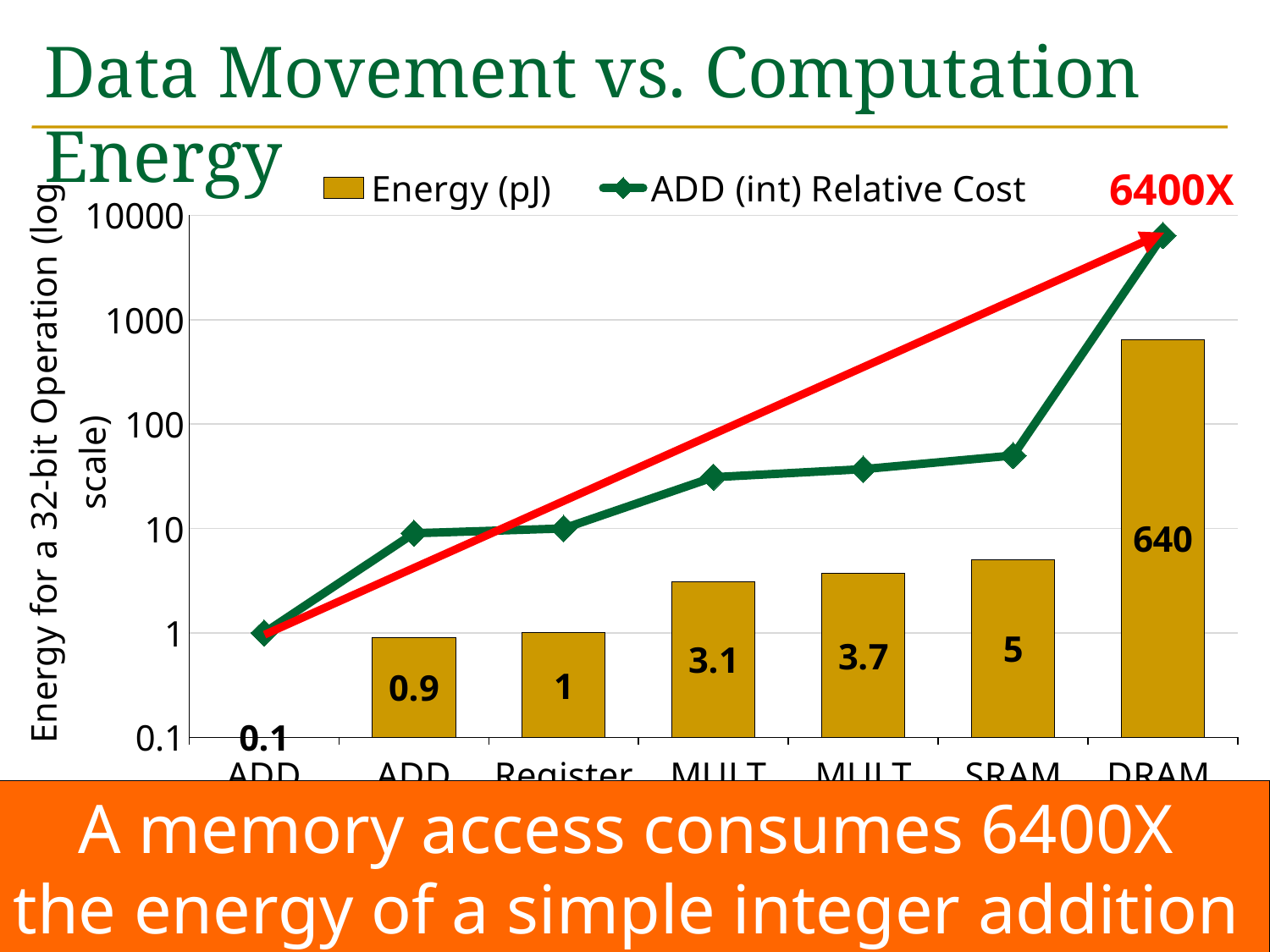
Which category has the lowest Energy (pJ) value? ADD (the first category, 0.1) Which has a larger Energy (pJ) value, SRAM or Register? SRAM What kind of chart is this? Combined bar and line chart What is the Energy (pJ) value shown for Register? 1 Which category has the highest Energy (pJ) bar? DRAM How many categories are shown on the x axis? 7 What is the difference between the Energy (pJ) values for DRAM and SRAM? 635 What is the Energy (pJ) value shown for DRAM? 640 How many series does the legend list? 2 Is the ADD (int) Relative Cost value at DRAM greater or less than 1000? greater What is the Energy (pJ) value shown for SRAM? 5 Is the ADD (int) Relative Cost value at SRAM greater or less than 10? greater